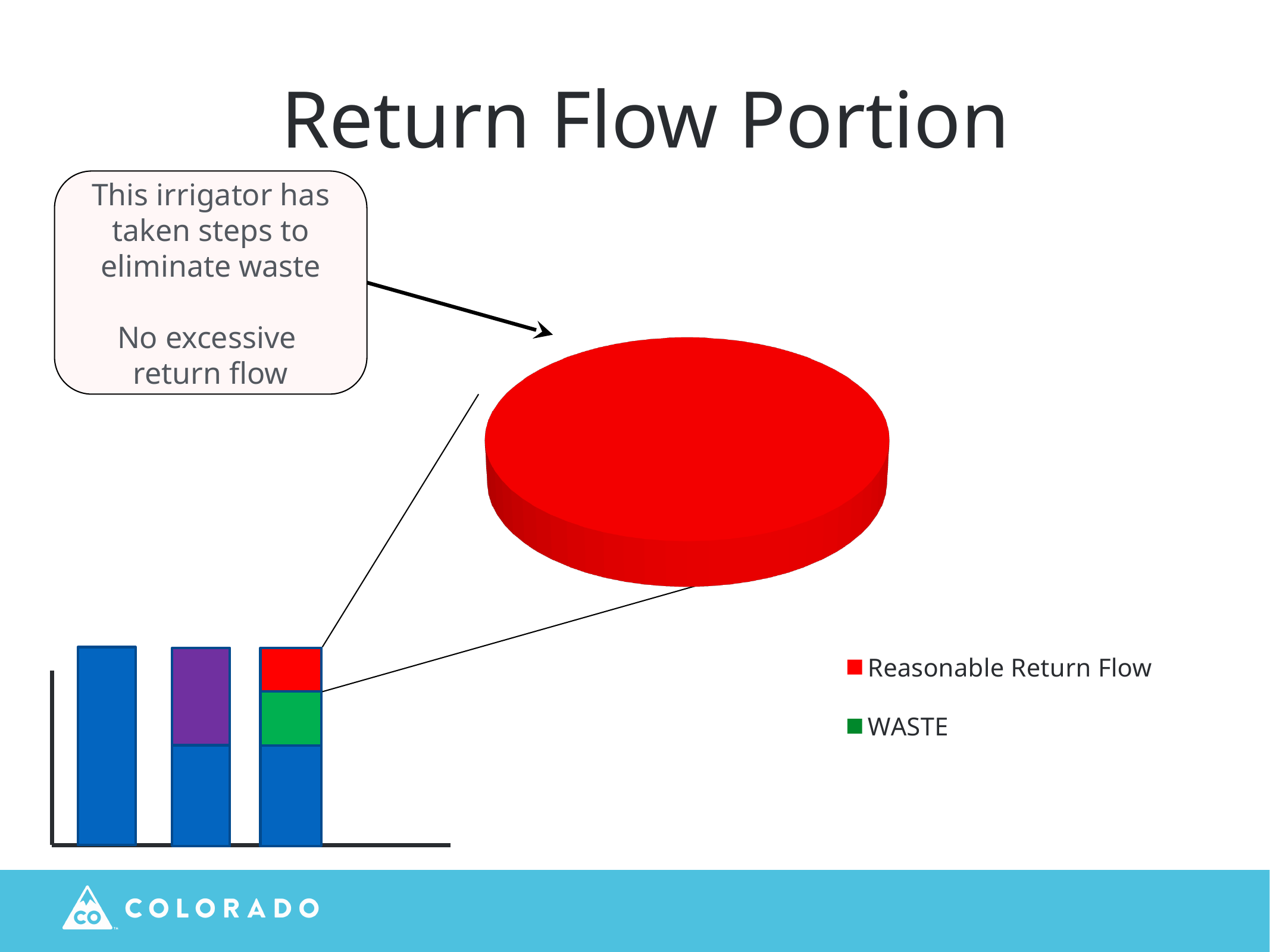
What colour represents Reasonable Return Flow in the pie chart legend? Red What kind of chart is the large red chart in the centre of the slide? Pie chart How many entries does the legend of the pie chart list? 2 How many bars are in the bar chart in the bottom-left corner of the slide? 3 In the pie chart, which is larger: the Reasonable Return Flow slice or the WASTE slice? Reasonable Return Flow What colour represents WASTE in the pie chart legend? Green What kind of chart is shown in the bottom-left corner of the slide? Bar chart Which legend entry accounts for the smallest share of the pie chart? WASTE Which legend entry accounts for the largest share of the pie chart? Reasonable Return Flow